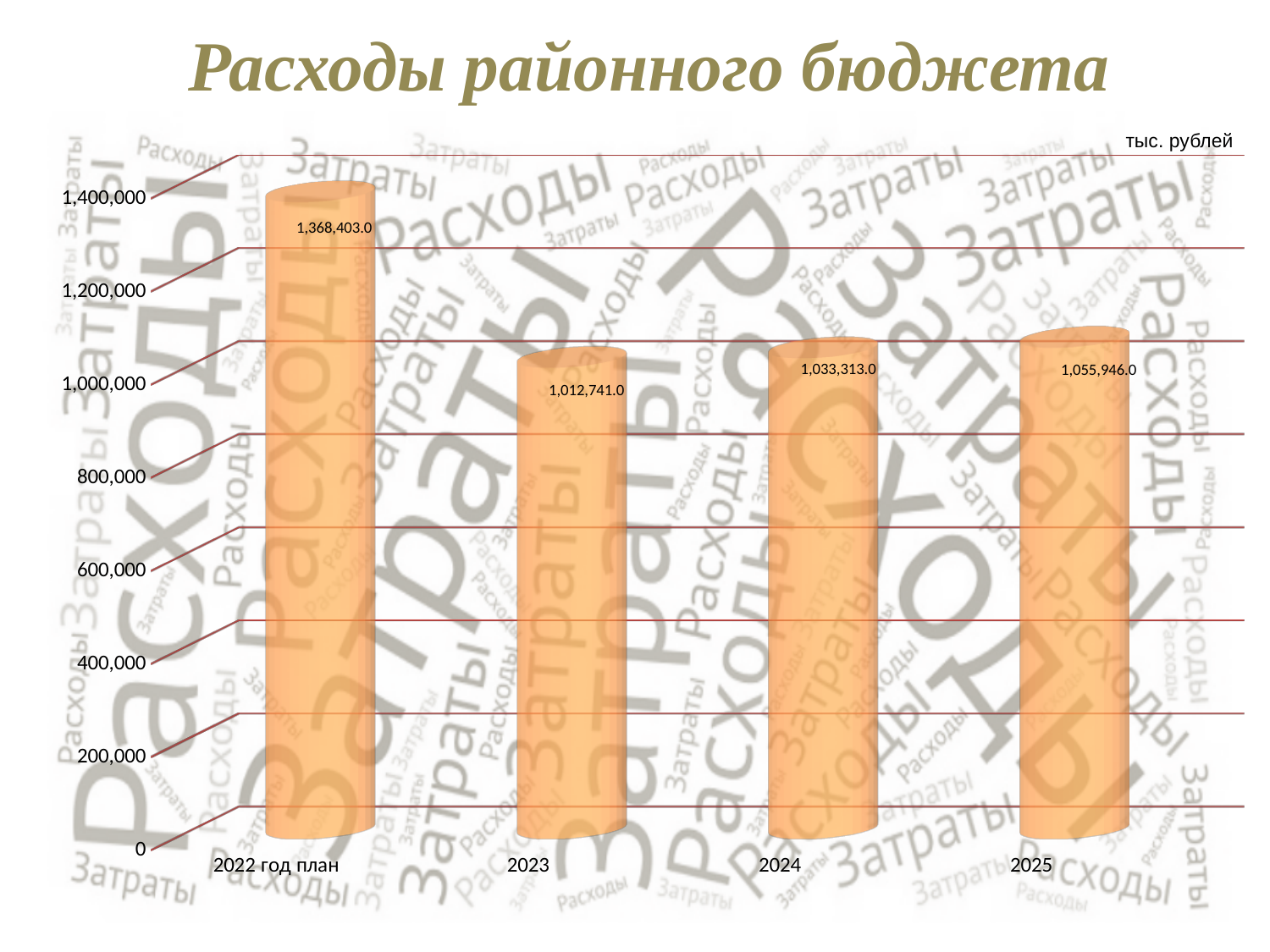
Which category has the lowest value? 2023 What is the difference between the values for 2025 and 2024? 22,633.0 What is the difference between the values for 2022 год план and 2023? 355,662.0 Which category has the highest value? 2022 год план What is the value for 2025? 1,055,946.0 What is the value for 2023? 1,012,741.0 Is the value for 2024 greater or less than 1,200,000? less Which is larger, the value for 2024 or the value for 2023? 2024 What is the value for 2022 год план? 1,368,403.0 What unit is indicated for the values on the chart? тыс. рублей What kind of chart is shown on the slide? bar chart How many categories are shown on the x axis? 4